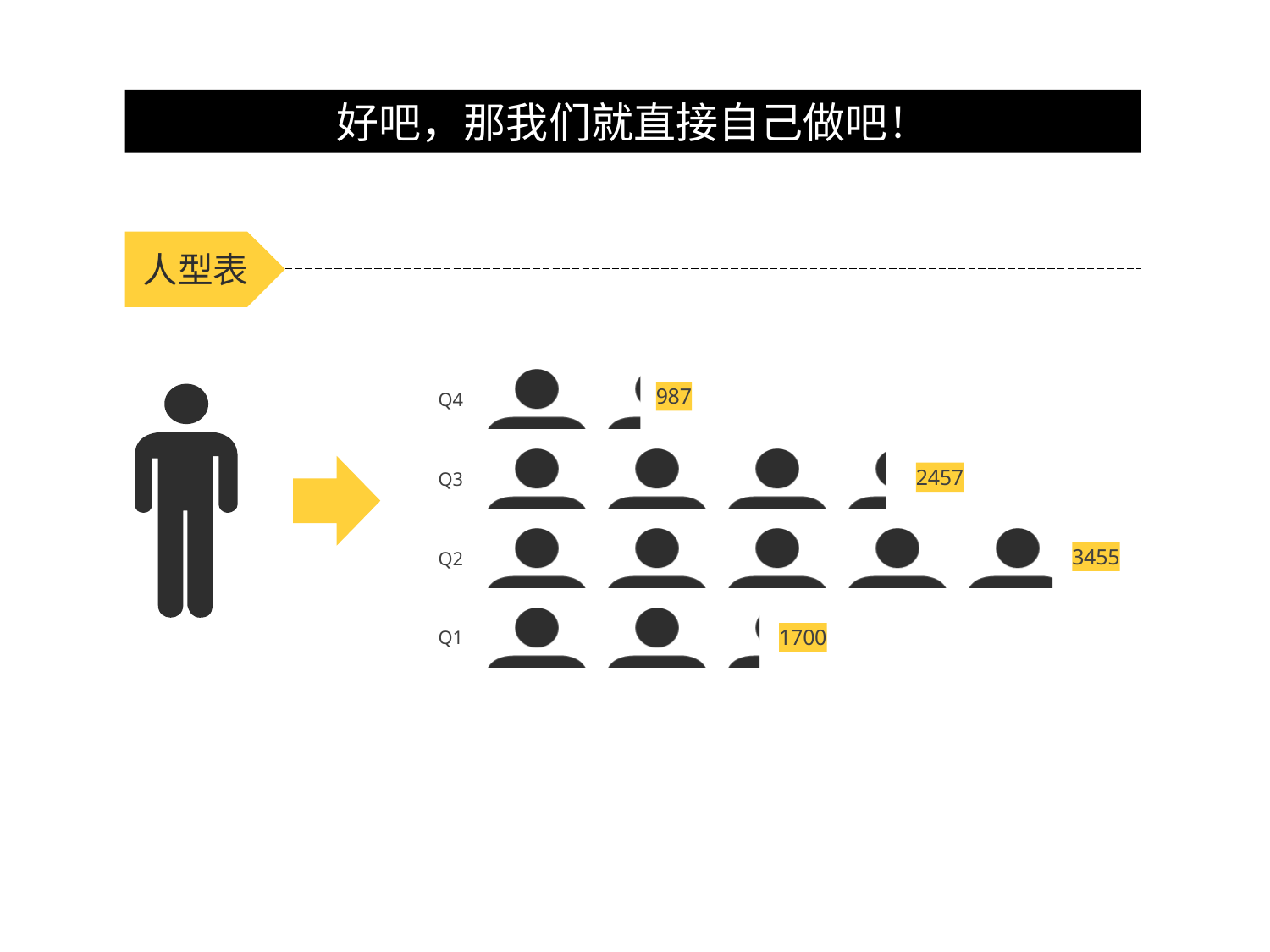
How many quarters are shown in the chart? 4 What kind of chart is this? Pictogram chart (person icons) What is the difference between the values for Q1 and Q4? 713 What is the value for Q3? 2457 Which quarter has the lowest value? Q4 What is the value for Q2? 3455 What is the value for Q4? 987 Which is larger, the value for Q1 or the value for Q3? Q3 What is the value for Q1? 1700 Do the values rise or fall from Q2 to Q4? Fall What is the difference between the values for Q2 and Q3? 998 Which quarter has the highest value? Q2